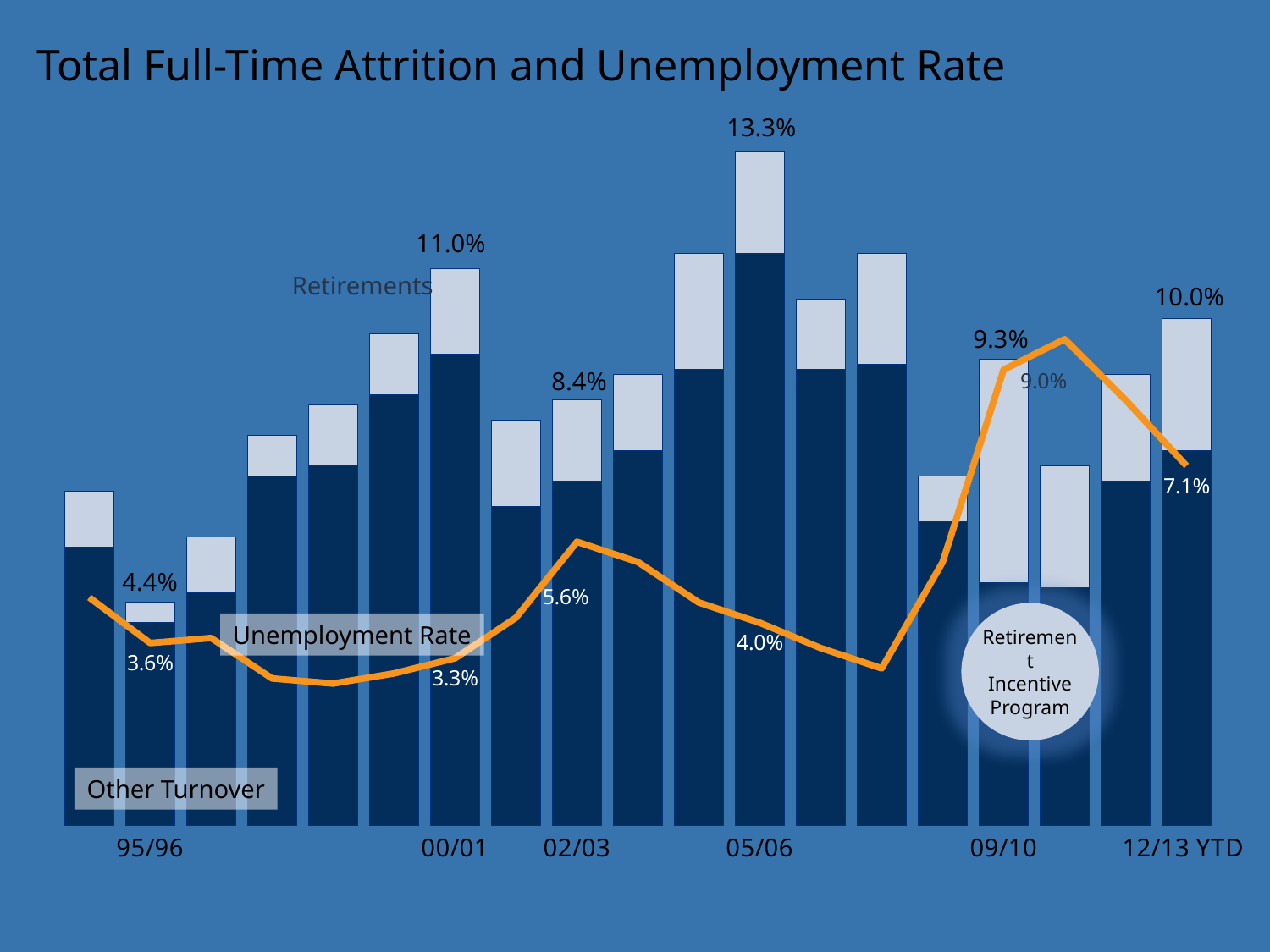
What does the lighter top segment of each bar represent? Retirements What was the unemployment rate in 12/13 YTD? 7.1% What was the unemployment rate in 00/01? 3.3% What was the total full-time attrition rate in 02/03? 8.4% What program is called out in the circular annotation near 10/11? Retirement Incentive Program What was the total full-time attrition rate in 05/06? 13.3% Did the unemployment rate rise or fall between 00/01 and 02/03? Rise In 09/10, which was larger: the total attrition rate or the unemployment rate? The total attrition rate (9.3%) What was the unemployment rate in 95/96? 3.6% Which year had the highest total full-time attrition? 05/06 What kind of chart is shown on the slide? A stacked bar chart with a line overlay What is the difference between the total attrition in 05/06 (13.3%) and in 95/96 (4.4%)? 8.9 percentage points